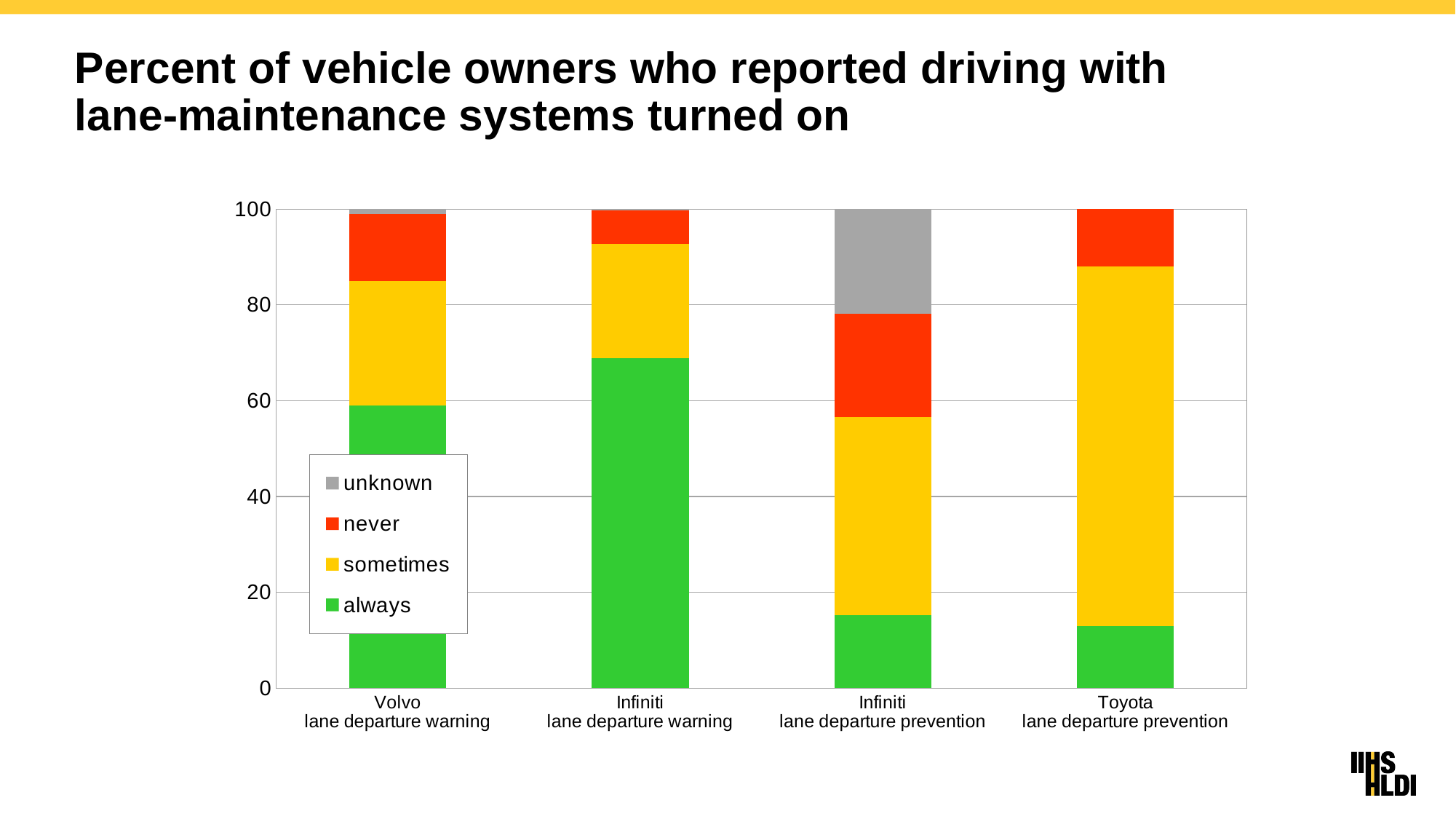
What kind of chart is shown on the slide? Stacked bar chart Which has a larger 'always' segment: Volvo lane departure warning or Infiniti lane departure warning? Infiniti lane departure warning Which category has the largest 'always' segment? Infiniti lane departure warning Which category has the smallest 'never' segment? Infiniti lane departure warning How many vehicle/system categories are shown along the x axis? 4 Is the 'always' value for Toyota lane departure prevention greater or less than 20? less Which category has the largest 'sometimes' segment? Toyota lane departure prevention What colour represents 'always' in the legend? Green Which has a larger 'sometimes' segment: Toyota lane departure prevention or Infiniti lane departure prevention? Toyota lane departure prevention Is the 'always' value for Volvo lane departure warning greater or less than 40? greater How many series does the legend list? 4 Which category has the largest 'unknown' segment? Infiniti lane departure prevention